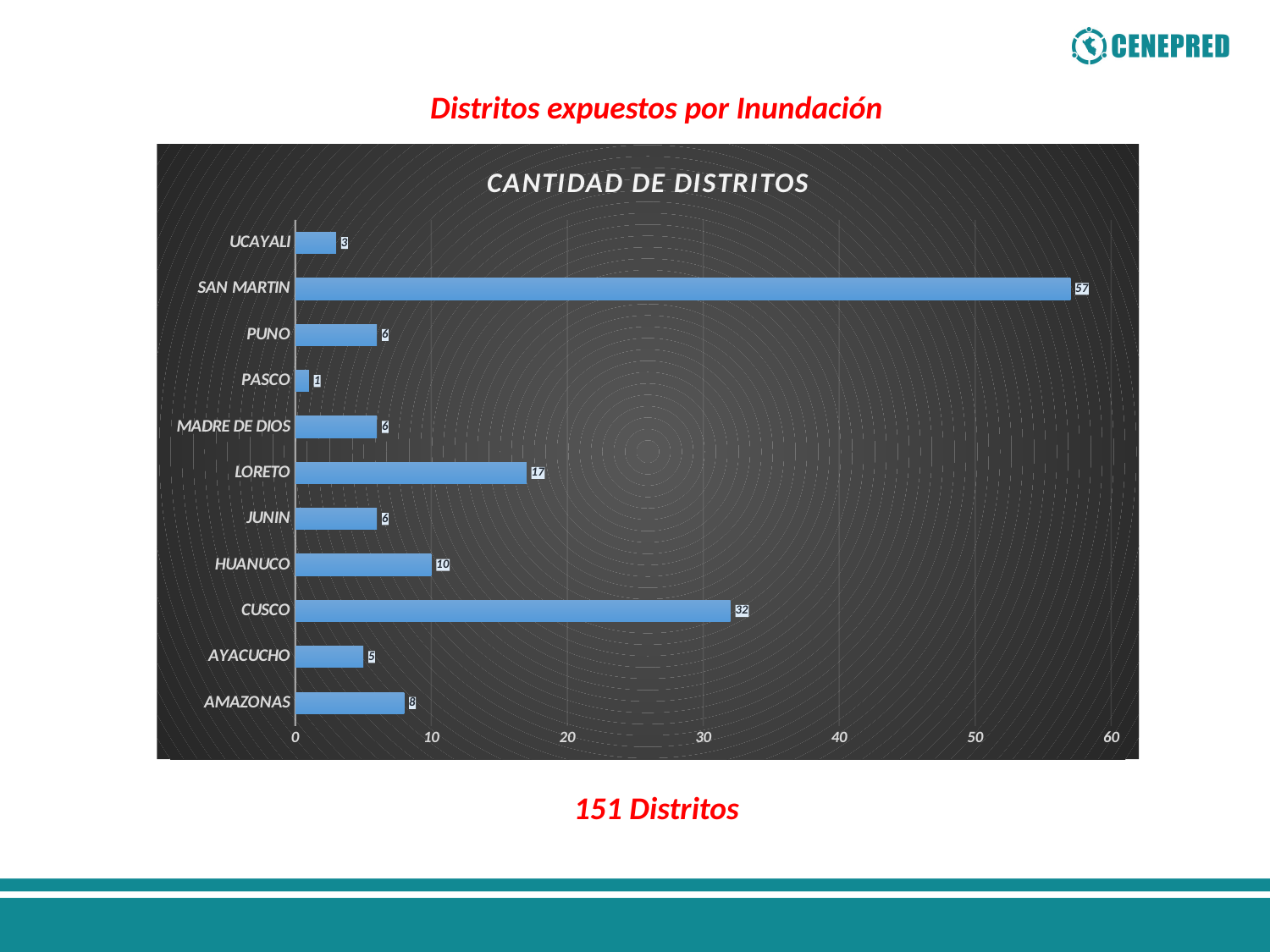
Which category has the highest value? SAN MARTIN How many categories are shown in the chart? 11 What is the difference between the values for SAN MARTIN and CUSCO? 25 What is the value for SAN MARTIN? 57 What is the value for LORETO? 17 What is the title of the chart? CANTIDAD DE DISTRITOS What is the value for CUSCO? 32 What is the value for AMAZONAS? 8 Which category has the lowest value? PASCO What kind of chart is shown on the slide? bar chart Which is larger, the value for HUANUCO or the value for AYACUCHO? HUANUCO Is the value for CUSCO greater or less than 30? greater